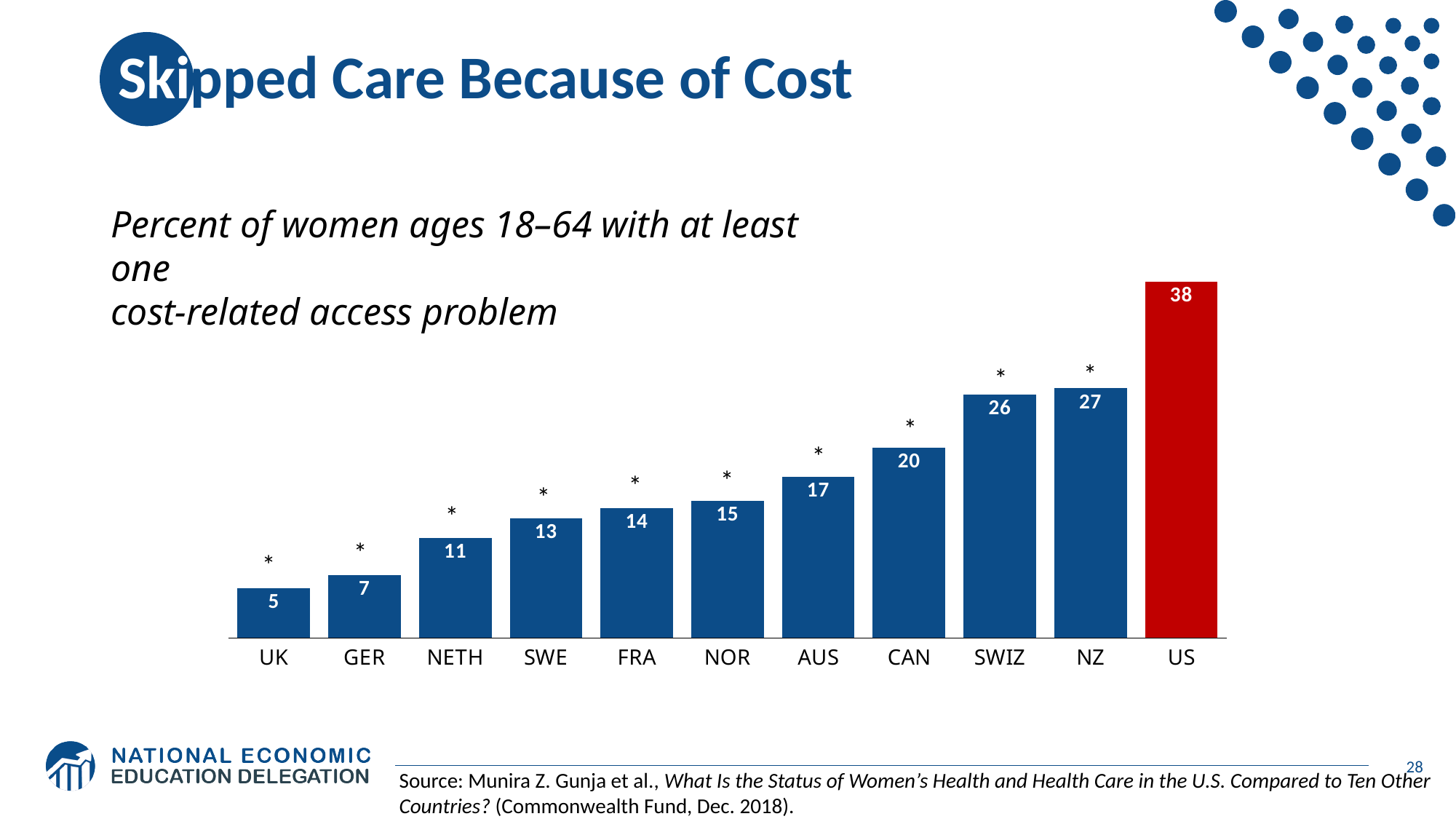
Do the values rise or fall from left to right along the x axis? Rise Which country has the highest value? US Which bar is coloured red rather than blue? US What kind of chart is shown on the slide? Bar chart What is the value for the US? 38 How many countries are shown on the chart? 11 Which country has the lowest value? UK What is the value for Germany (GER)? 7 What is the difference between the values for the US and NZ? 11 What is the difference between the values for SWIZ and UK? 21 Which is larger, the value for AUS or the value for FRA? AUS What is the value for Canada (CAN)? 20